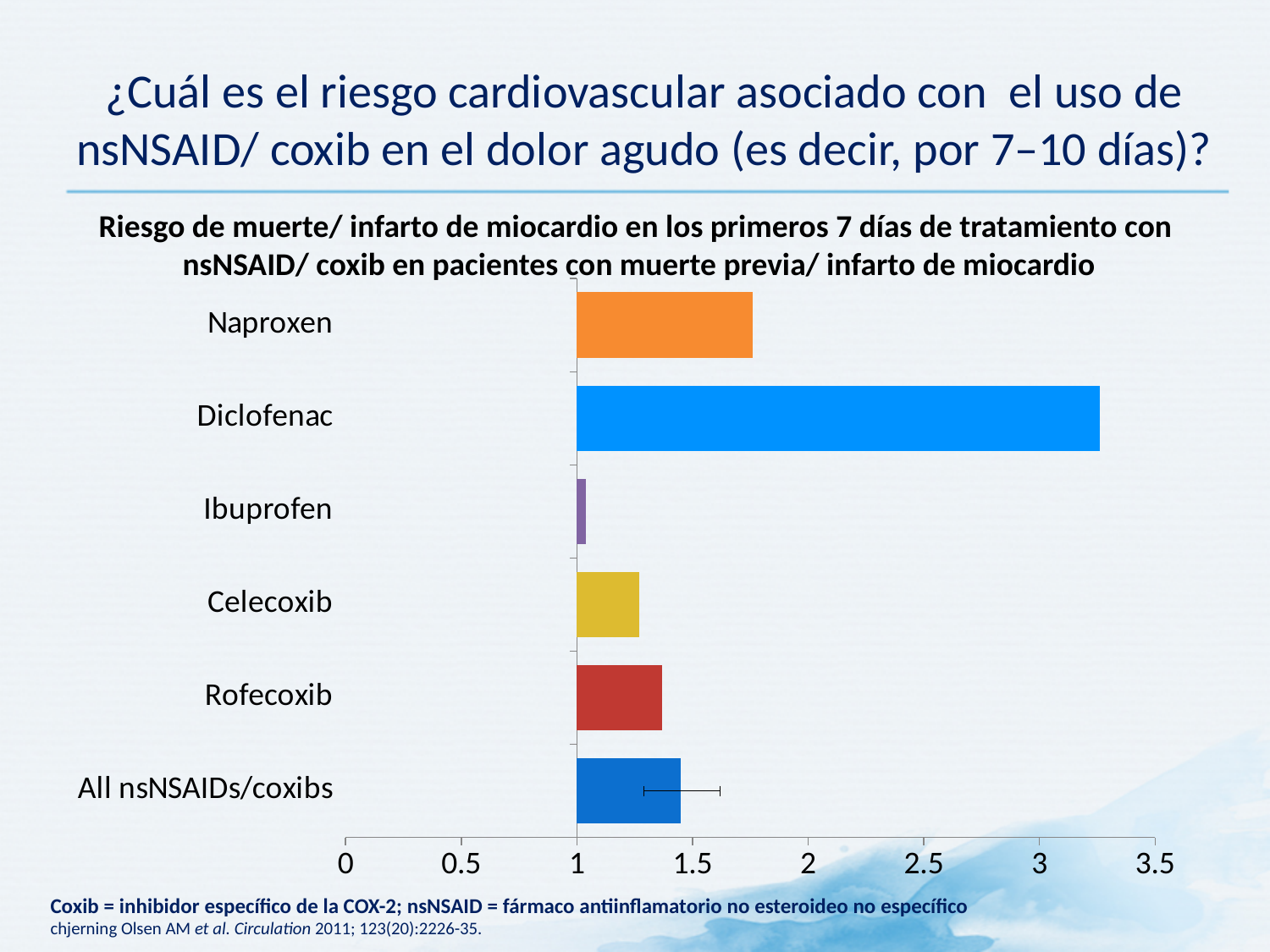
What kind of chart is shown on the slide? bar chart Is the value for Diclofenac greater or less than 3? greater What is the highest tick value shown on the horizontal axis of the chart? 3.5 Is the value for Celecoxib greater or less than 1.5? less Which category has the lowest value in the chart? Ibuprofen How many drug categories are plotted in the chart? 6 Is the value for Naproxen greater or less than 1.5? greater Which is larger, the value for Naproxen or the value for Celecoxib? Naproxen Which is larger, the value for Diclofenac or the value for Rofecoxib? Diclofenac Which category has the highest value in the chart? Diclofenac